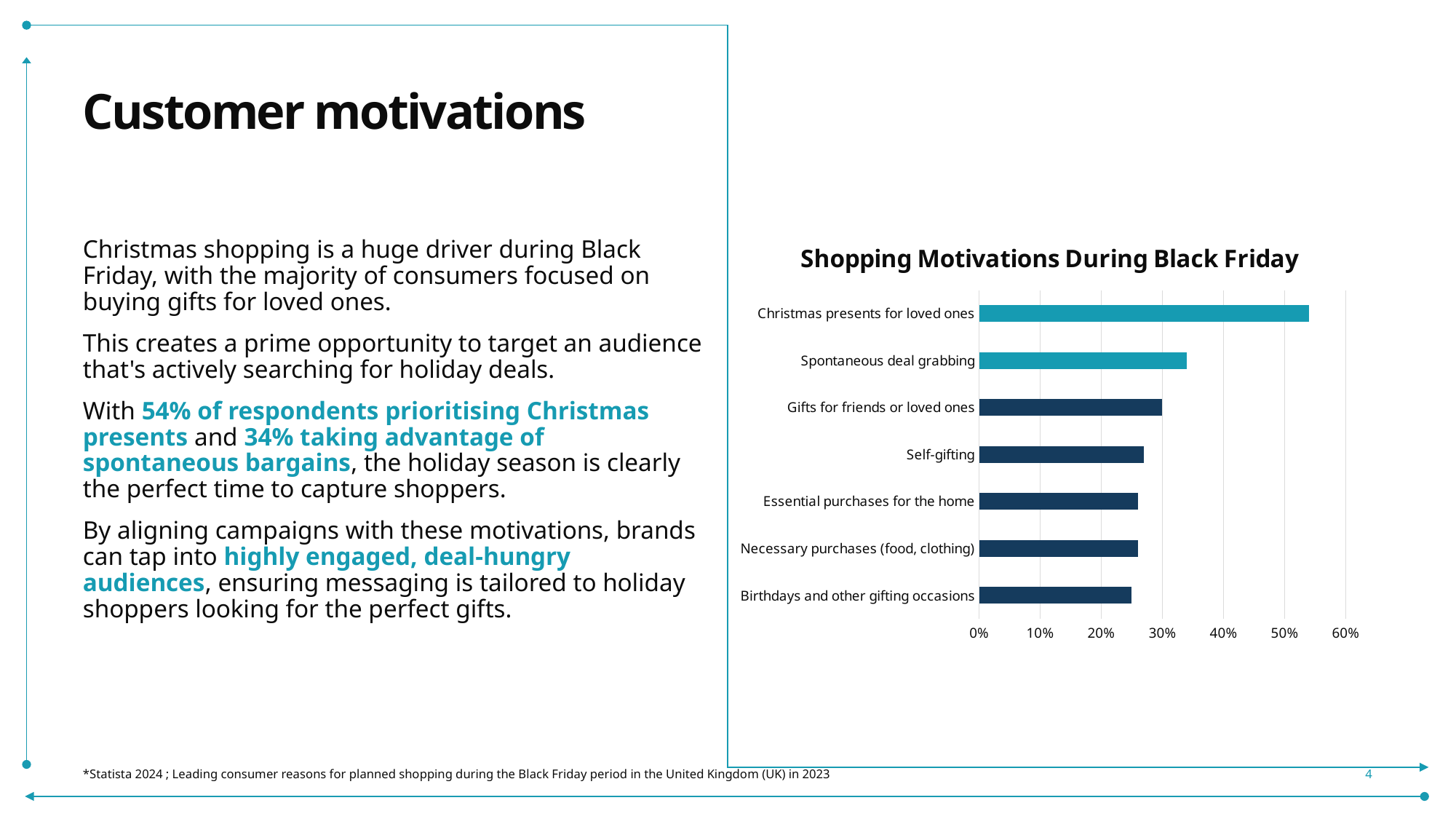
Is the value for Self-gifting greater or less than 30%? less What is the difference in percentage points between Christmas presents for loved ones and Spontaneous deal grabbing? 20 percentage points What type of chart is shown on the slide? Bar chart Is the value for Birthdays and other gifting occasions greater or less than 20%? greater Which shopping motivation has the highest value in the chart? Christmas presents for loved ones What is the title of the chart? Shopping Motivations During Black Friday How many shopping motivations are plotted in the chart? 7 Which two bars in the chart are shown in a lighter teal colour than the others? Christmas presents for loved ones and Spontaneous deal grabbing What percentage of respondents chose Christmas presents for loved ones as a motivation? 54% Is the value for Essential purchases for the home greater or less than 30%? less What percentage of respondents chose Spontaneous deal grabbing as a motivation? 34% Which is larger: the value for Spontaneous deal grabbing or the value for Self-gifting? Spontaneous deal grabbing